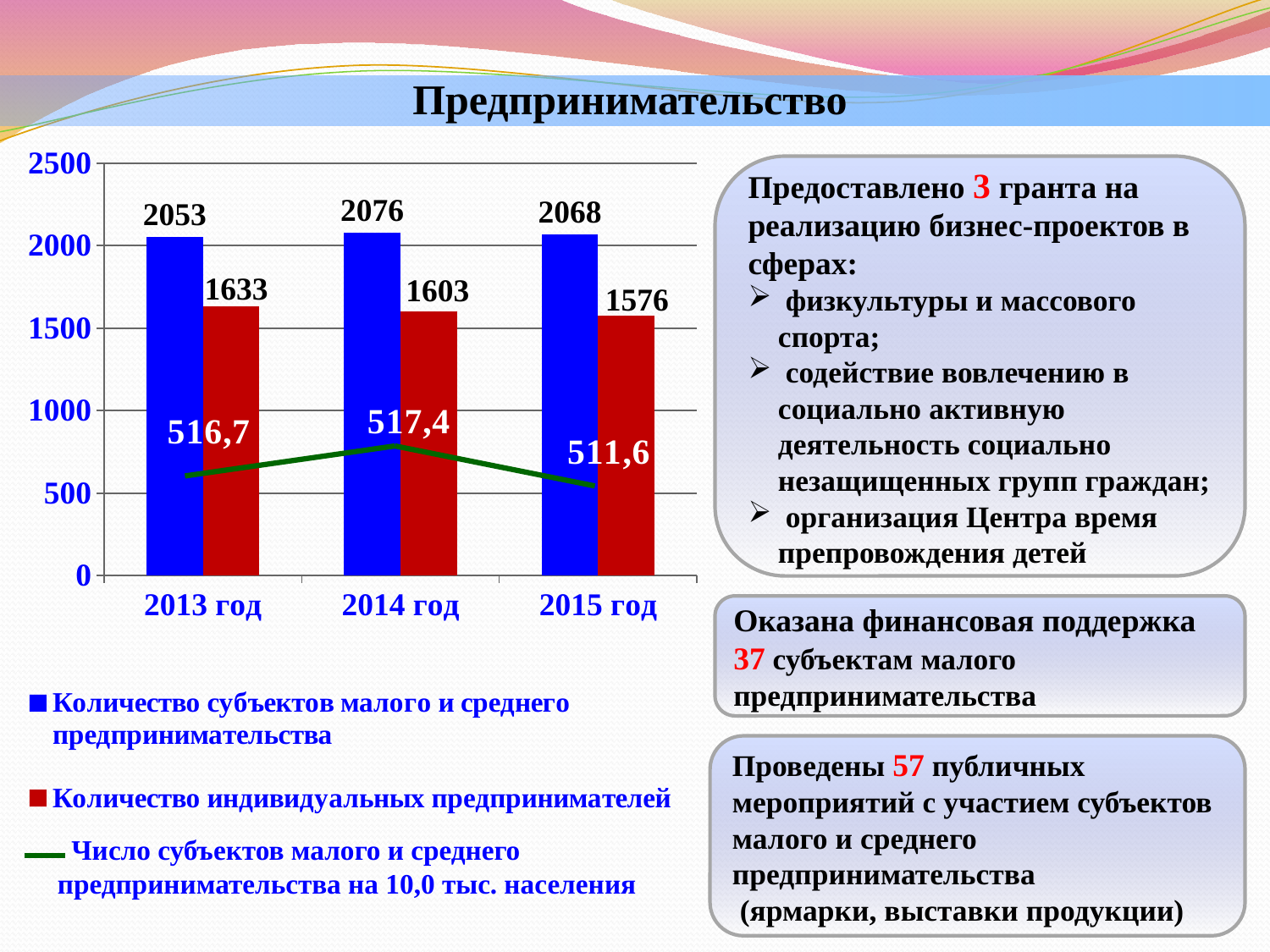
How does 'Количество индивидуальных предпринимателей' change from 2013 год to 2015 год? It falls How many years are shown on the x axis of the chart? 3 What is the value of 'Количество индивидуальных предпринимателей' for 2015 год? 1576 What is the difference between 'Количество субъектов малого и среднего предпринимательства' and 'Количество индивидуальных предпринимателей' in 2013 год? 420 Which is larger: 'Количество индивидуальных предпринимателей' in 2014 год or in 2015 год? 2014 год How many series does the chart legend list? 3 In which year is 'Число субъектов малого и среднего предпринимательства на 10,0 тыс. населения' the lowest? 2015 год In which year is 'Количество индивидуальных предпринимателей' the highest? 2013 год What colour are the bars for 'Количество субъектов малого и среднего предпринимательства'? Blue What is the value of 'Количество субъектов малого и среднего предпринимательства' for 2014 год? 2076 What is the value of 'Число субъектов малого и среднего предпринимательства на 10,0 тыс. населения' for 2013 год? 516,7 Is the value of 'Количество индивидуальных предпринимателей' for 2013 год greater or less than 1500? greater